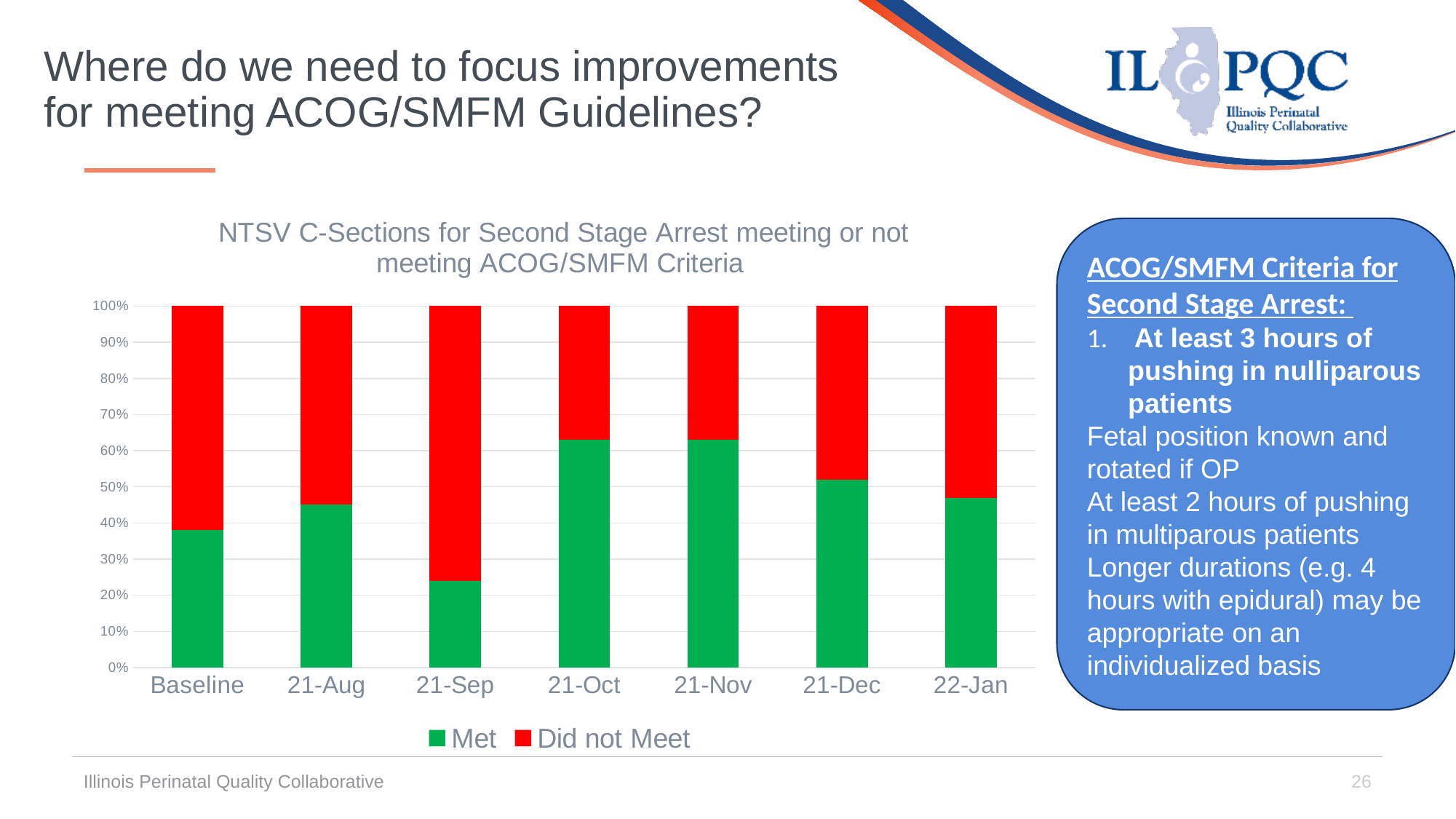
How many categories are shown along the x axis of the chart? 7 How many series does the chart legend list? 2 What kind of chart is shown on the slide? stacked bar chart Is the 'Met' value for 21-Sep greater or less than 30%? less Which category has the highest 'Did not Meet' share? 21-Sep Which category has the lowest 'Met' share? 21-Sep What is the total height of the stacked bar for Baseline? 100% Is the 'Met' value for 21-Oct greater or less than 60%? greater What is the title of the chart? NTSV C-Sections for Second Stage Arrest meeting or not meeting ACOG/SMFM Criteria Which has the larger 'Met' share, 21-Aug or 21-Sep? 21-Aug Is the 'Met' value for 22-Jan greater or less than 50%? less